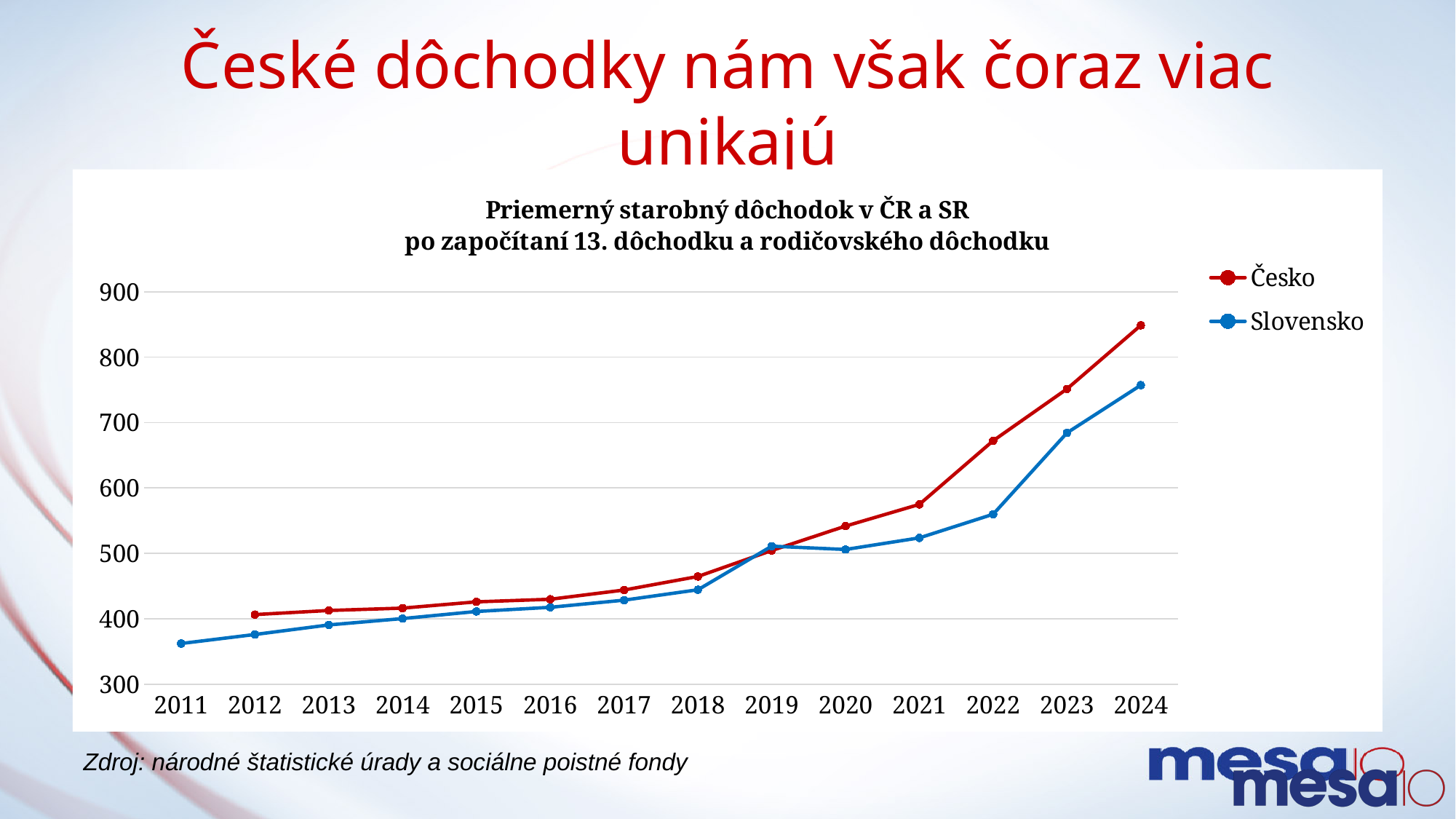
Is the value for Slovensko in 2011 greater or less than 400? less What kind of chart is shown on the slide? line chart Which series has the higher value in 2024, Česko or Slovensko? Česko Which series is drawn in red? Česko Is the value for Slovensko in 2024 greater or less than 700? greater Is the value for Česko in 2024 greater or less than 800? greater How many years are shown on the x axis? 14 In which year does the Slovensko series have its lowest value? 2011 In which year does the Česko series reach its highest value? 2024 Do the values for Česko rise or fall from 2012 to 2024? rise How many series does the legend list? 2